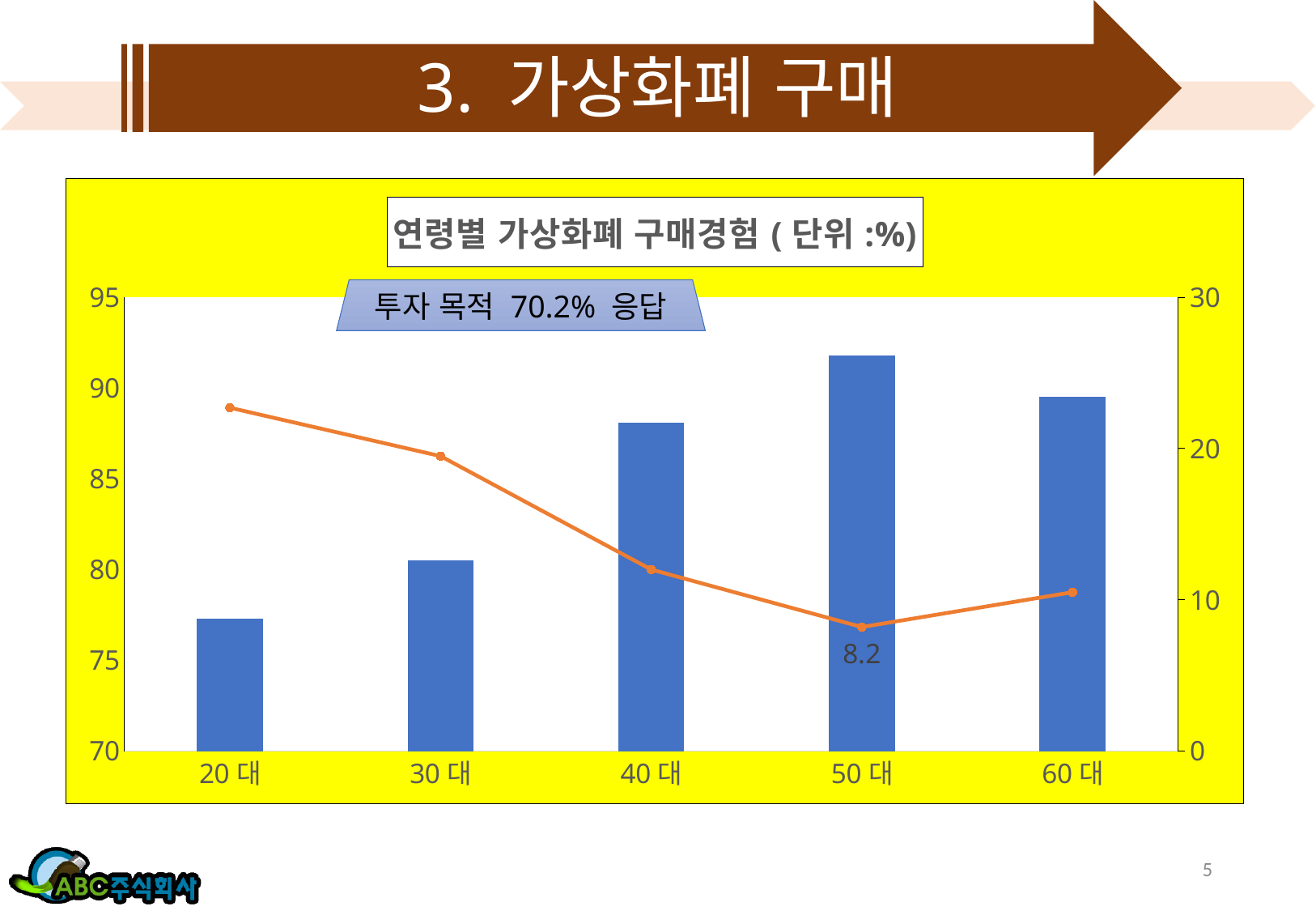
What is the title of the chart? 연령별 가상화폐 구매경험 ( 단위 :%) At which age group does the line series reach its lowest point? 50 대 What is the value of the line series for 50 대? 8.2 Is the bar value for 50 대 greater or less than 90 on the left axis? greater Which age group has the tallest bar? 50 대 Is the line value for 20 대 greater or less than 20 on the right axis? greater Is the bar value for 20 대 greater or less than 80 on the left axis? less Which has the taller bar, 30 대 or 40 대? 40 대 At which age group does the line series reach its highest point? 20 대 How many age groups are shown on the x axis? 5 Does the line series rise or fall from 20 대 to 50 대? fall Which age group has the shortest bar? 20 대